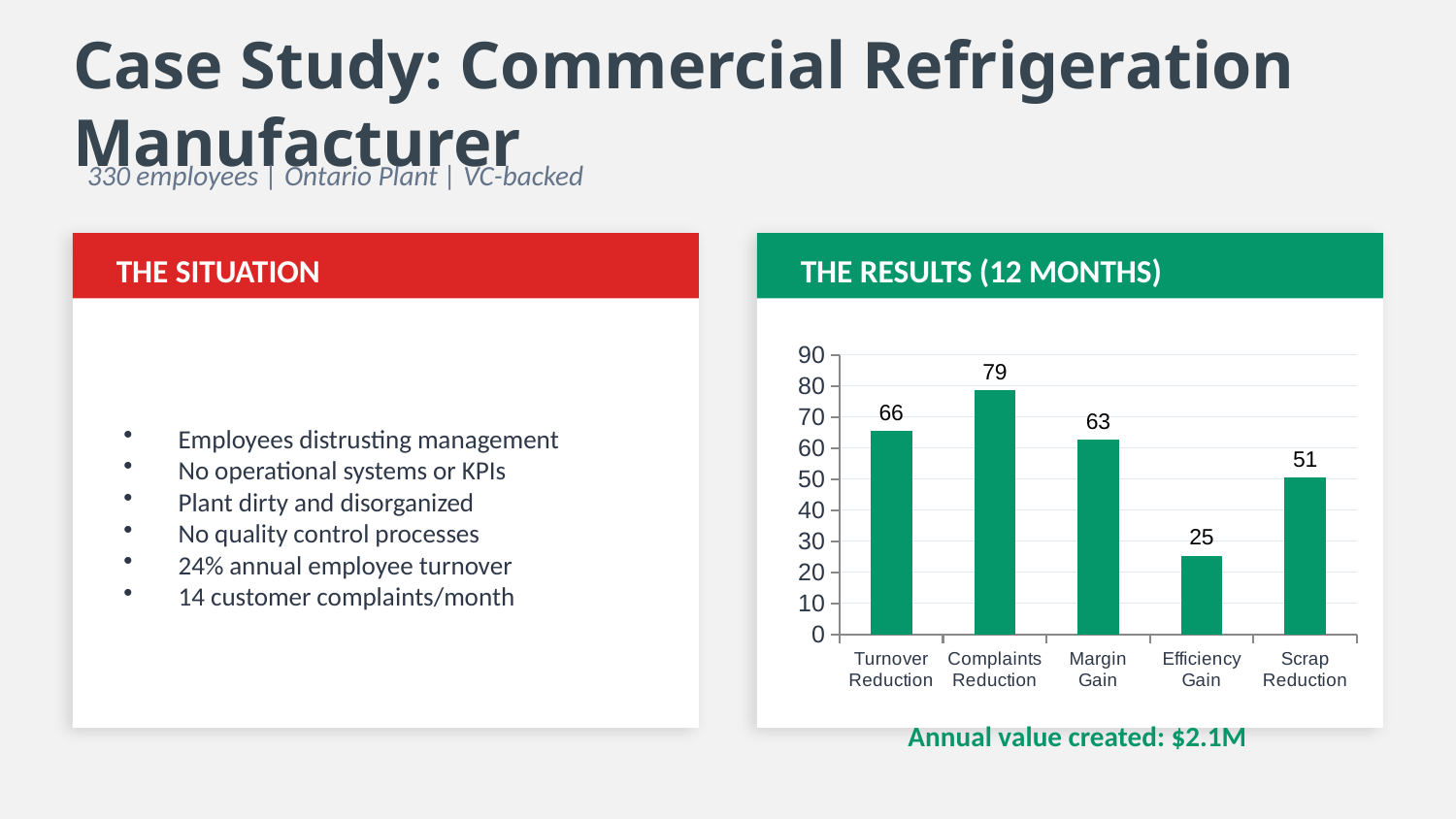
What is the difference between the values for Complaints Reduction and Margin Gain? 16 Is the value for Margin Gain greater or less than 60? greater What is the value for Scrap Reduction? 51 Which is larger, the value for Turnover Reduction or the value for Scrap Reduction? Turnover Reduction What is the value for Efficiency Gain? 25 What is the value for Complaints Reduction? 79 What colour are the bars in the chart? Green How many categories are shown in the chart? 5 Which category has the highest value? Complaints Reduction What is the title of the panel containing the chart? THE RESULTS (12 MONTHS) Which category has the lowest value? Efficiency Gain What kind of chart is shown on the slide? Bar chart